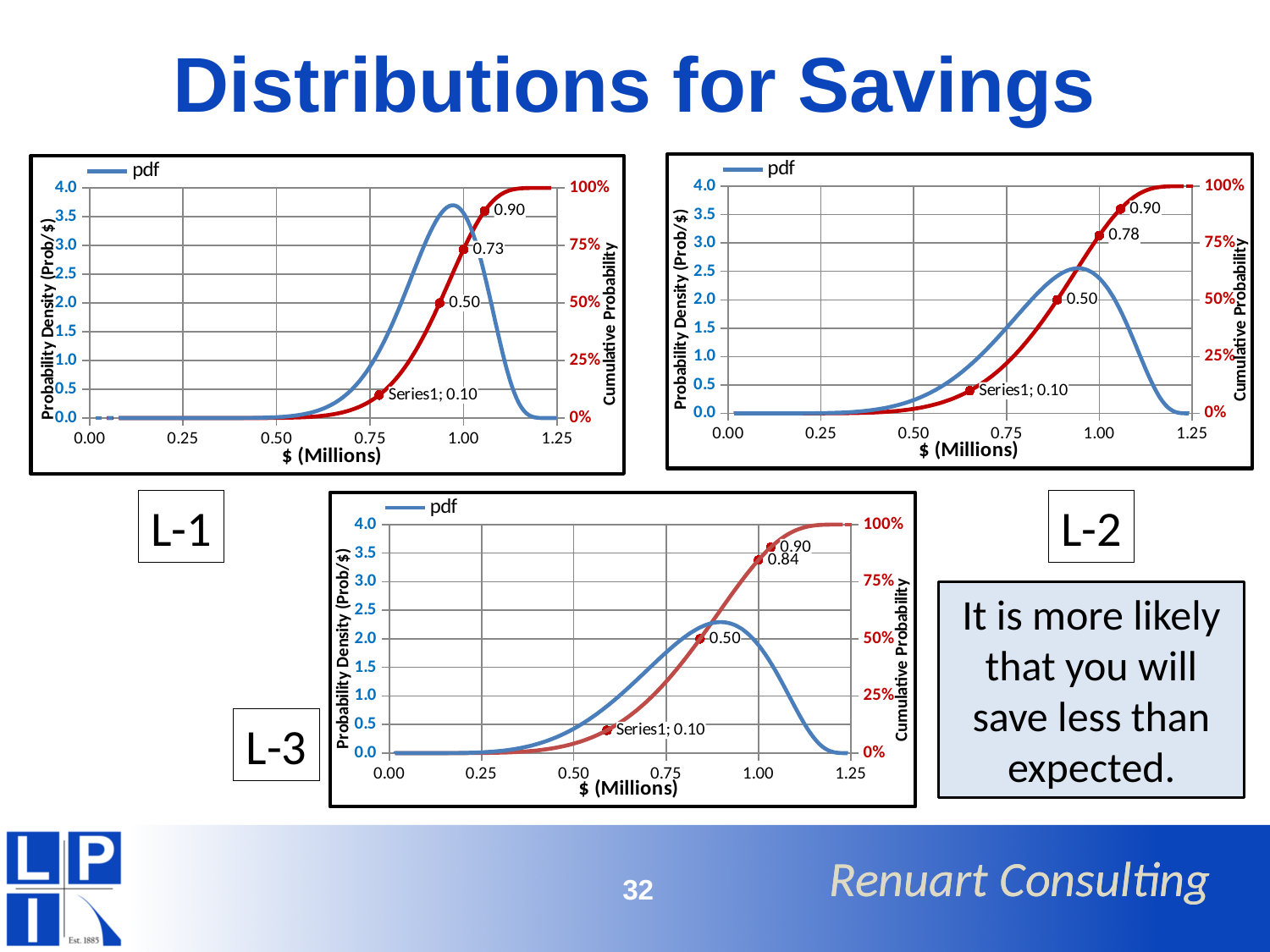
In the L-2 chart, what cumulative probability value is labelled on the red curve at $1.00 million? 0.78 In the L-1 chart, is the peak of the pdf curve greater or less than 3.0? greater What kind of chart is the L-1 chart? line chart In the L-2 chart, does the cumulative probability curve rise or fall as $ (Millions) increases? rise Across the three charts, which one shows the highest labelled cumulative probability at $1.00 million? L-3 In the L-3 chart, what cumulative probability value is labelled on the red curve at $1.00 million? 0.84 How many labelled points are marked on the red cumulative probability curve in the L-1 chart? 4 In the L-1 chart, what cumulative probability value is labelled on the red curve at $1.00 million? 0.73 What is the x-axis title of the L-3 chart? $ (Millions) In the L-3 chart, is the peak of the pdf curve greater or less than 2.5? less In the L-2 chart, is the peak of the pdf curve greater or less than 3.0? less What is the difference between the labelled cumulative probability at $1.00 million in the L-3 chart (0.84) and in the L-1 chart (0.73)? 0.11